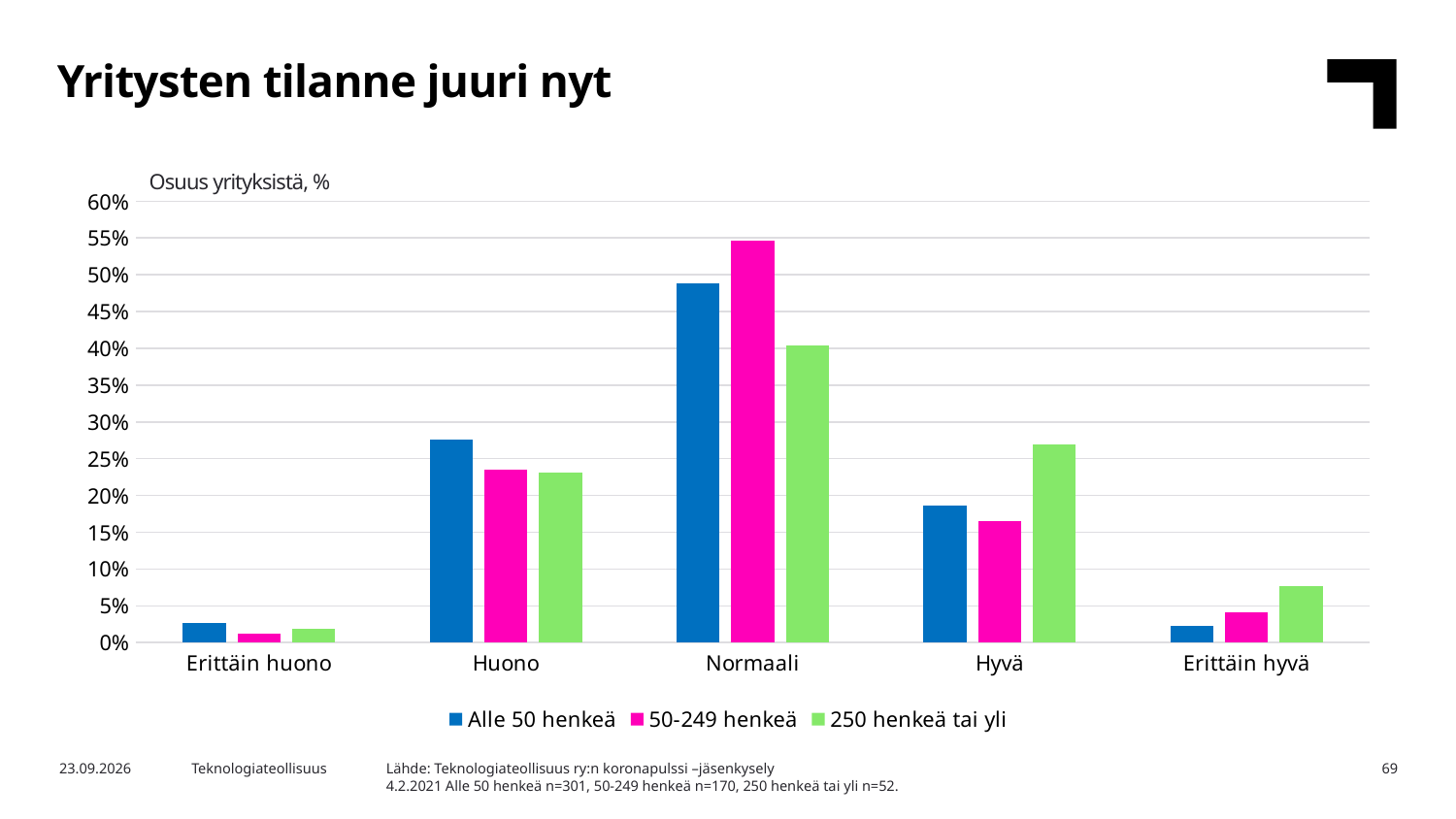
In the Hyvä category, which is larger: the value for Alle 50 henkeä or for 250 henkeä tai yli? 250 henkeä tai yli In the Erittäin hyvä category, which series has the highest value? 250 henkeä tai yli Which series has the lowest value in the Normaali category? 250 henkeä tai yli Is the value for 250 henkeä tai yli in the Hyvä category greater or less than 25%? greater What kind of chart is shown on the slide? bar chart How many categories are shown on the x axis? 5 What is the title of the chart on the slide? Yritysten tilanne juuri nyt Which series has the highest value in the Normaali category? 50-249 henkeä How many series does the legend list? 3 Is the value for 50-249 henkeä in the Normaali category greater or less than 50%? greater Which category has the highest value for the 50-249 henkeä series? Normaali Is the value for Alle 50 henkeä in the Huono category greater or less than 25%? greater